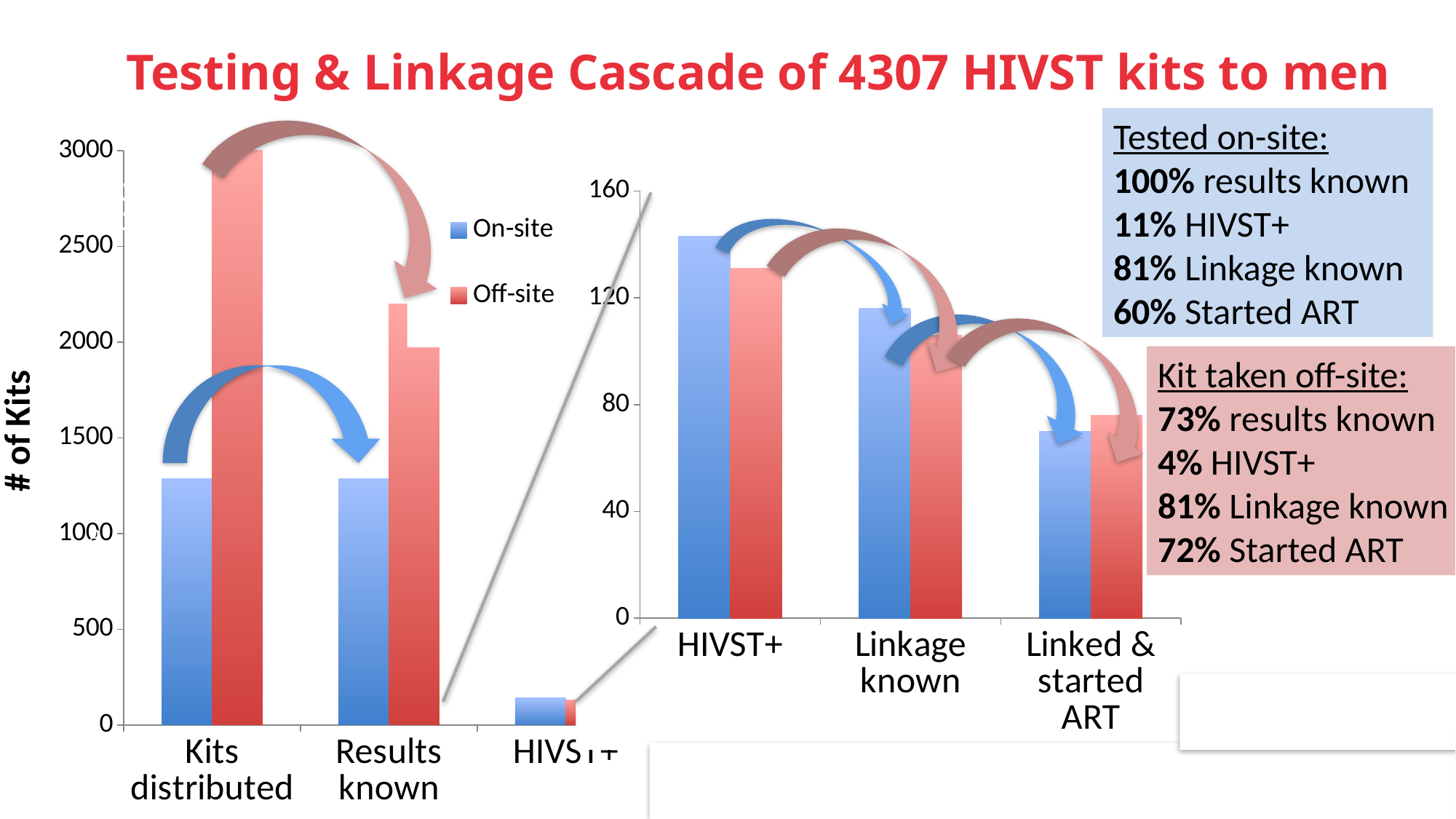
What is the y-axis title of the left chart? # of Kits What kind of chart is the left chart on the slide? bar chart In the left chart, is the Off-site value for Kits distributed greater or less than 2500? greater In the right (inset) chart, is the On-site value for HIVST+ greater or less than 120? greater How many series does the legend of the left chart list? 2 In the right (inset) chart, do the On-site values rise or fall from HIVST+ to Linked & started ART? fall In the left chart, is the On-site value for Kits distributed greater or less than 1000? greater In the left chart, for Results known, which series has the larger value, On-site or Off-site? Off-site In the left chart, which category has the tallest bar? Kits distributed How many categories are shown on the x axis of the right (inset) chart? 3 In the left chart, which category has the lowest bars? HIVST+ How many categories are shown on the x axis of the left chart? 3